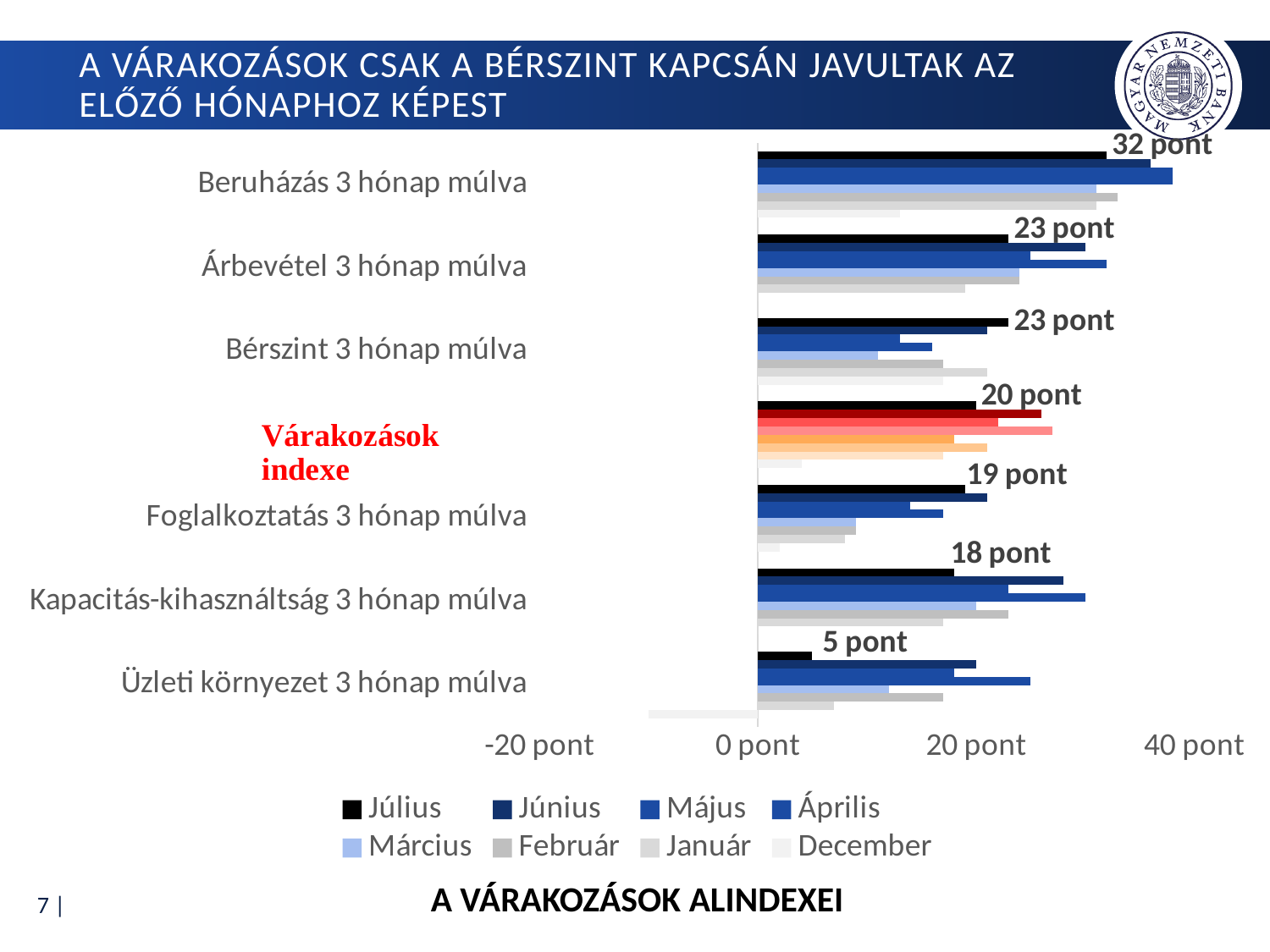
What is the July (Július) value for Kapacitás-kihasználtság 3 hónap múlva? 18 pont Which has the larger July value: Foglalkoztatás 3 hónap múlva or Árbevétel 3 hónap múlva? Árbevétel 3 hónap múlva Which category has the highest July (Július) value? Beruházás 3 hónap múlva What is the July (Július) value for Üzleti környezet 3 hónap múlva? 5 pont Which category has the lowest July (Július) value? Üzleti környezet 3 hónap múlva What is the difference between the July values for Beruházás 3 hónap múlva and Üzleti környezet 3 hónap múlva? 27 pont How many series does the legend list? 8 How many categories are shown on the chart? 7 What kind of chart is shown on the slide? bar chart What is the July (Július) value for Beruházás 3 hónap múlva? 32 pont What is the July (Július) value for Várakozások indexe? 20 pont Is the December value for Üzleti környezet 3 hónap múlva greater or less than 0 pont? less